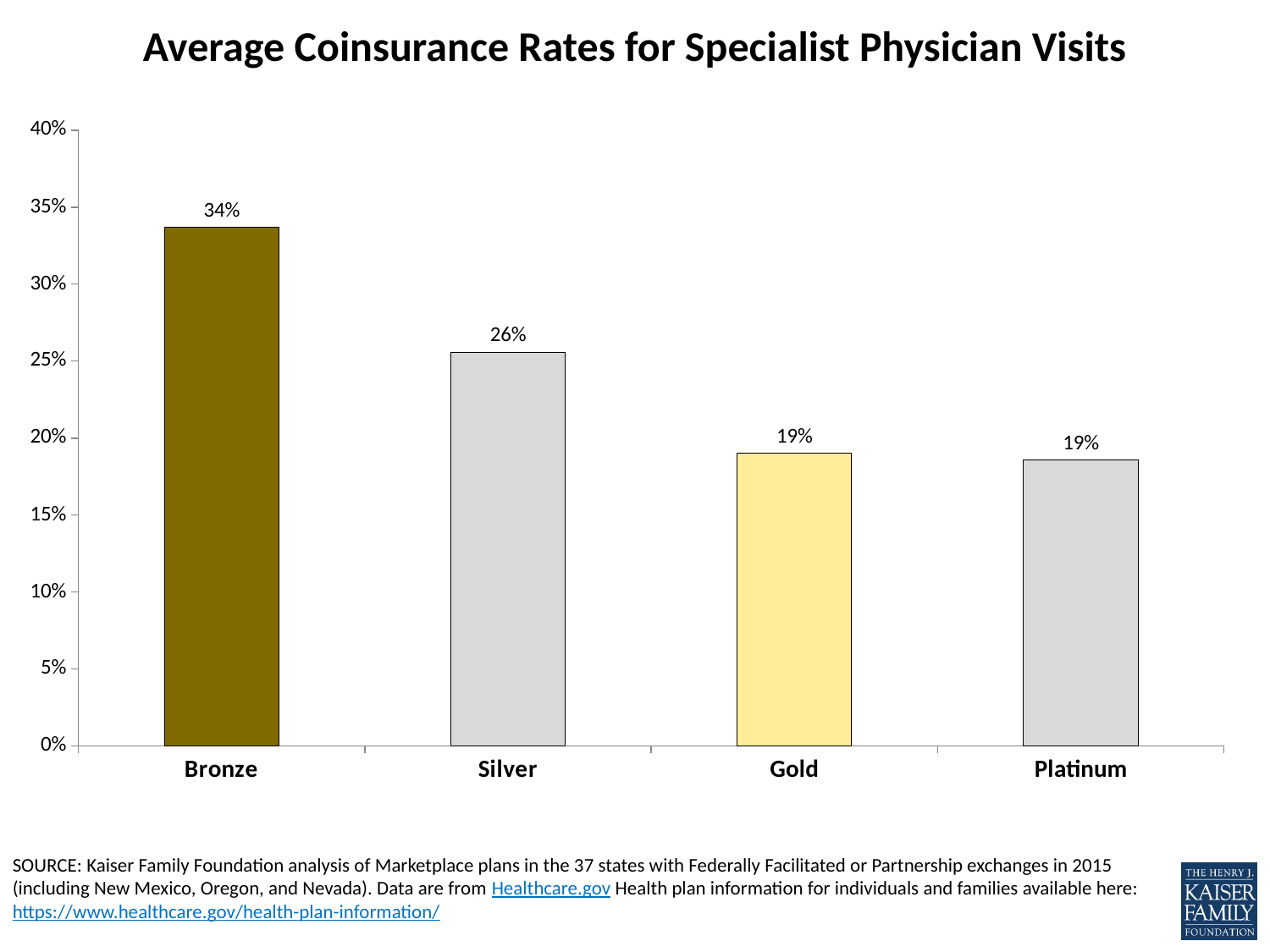
Which plan tier has the highest average coinsurance rate for specialist physician visits? Bronze What is the average coinsurance rate for Silver plans? 26% What is the title of the chart? Average Coinsurance Rates for Specialist Physician Visits How many plan tiers are shown on the chart? 4 What is the average coinsurance rate for Platinum plans? 19% What is the average coinsurance rate for Gold plans? 19% Which has a higher average coinsurance rate, Silver or Platinum? Silver What is the difference in average coinsurance rate between Bronze and Silver plans? 8 percentage points What is the difference in average coinsurance rate between Silver and Gold plans? 7 percentage points Do the average coinsurance rates rise or fall moving from Bronze to Platinum? Fall What is the average coinsurance rate for Bronze plans? 34% What kind of chart is shown on the slide? Bar chart